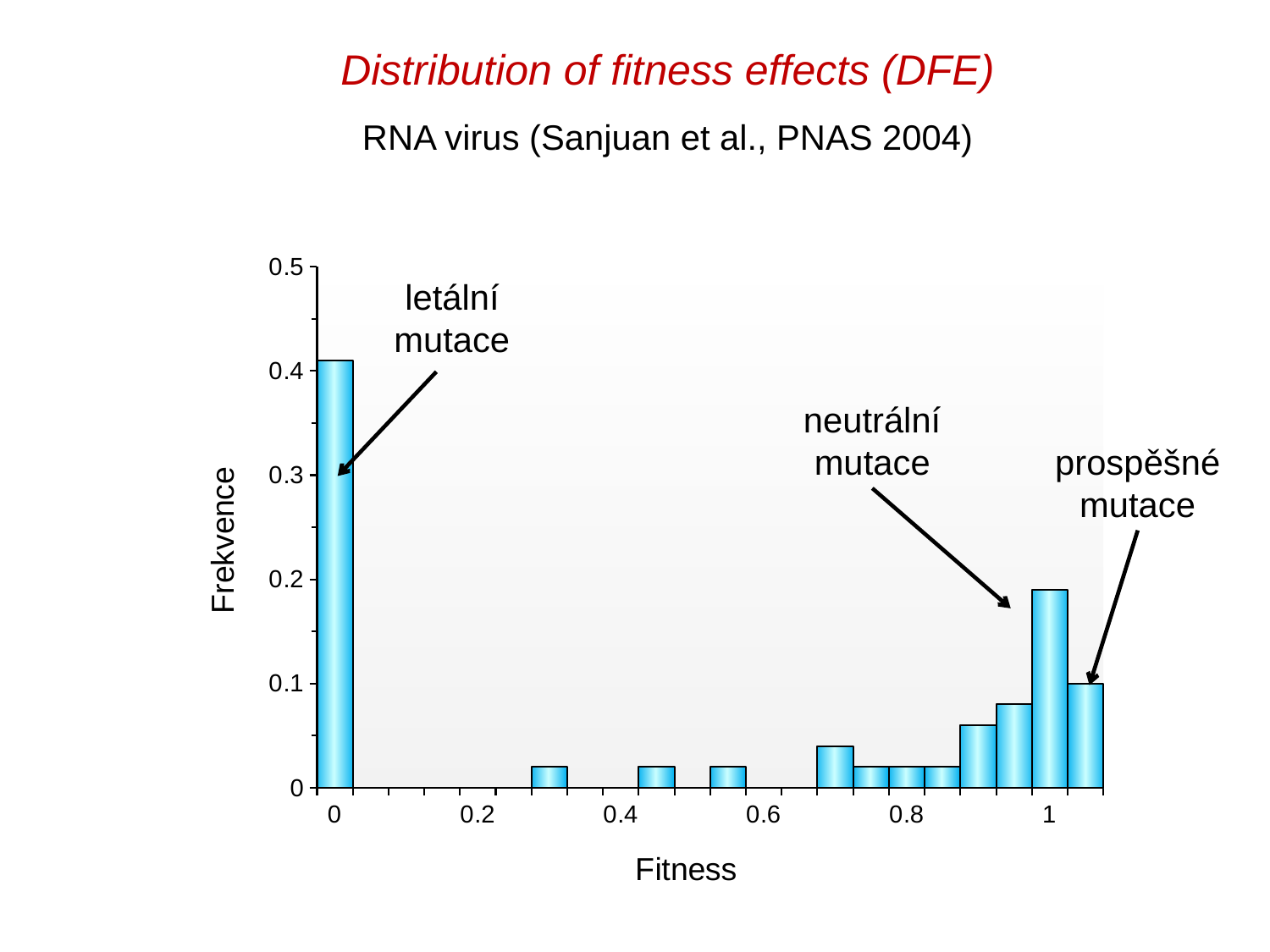
At which fitness value is the frequency highest? 0 Which has the higher frequency, the bar at fitness 0 or the bar at fitness 1? fitness 0 Which annotation points to the bar at fitness 0? letální mutace Is the frequency for fitness 0 greater or less than 0.3? greater What kind of chart is shown on the slide? bar chart Is the frequency for the bar at fitness 1 greater or less than 0.2? less Do the bar heights rise or fall as fitness increases from 0.7 to 1? rise How many bars are plotted in the chart? 12 Is the frequency for the bar at fitness 0.9 greater or less than 0.1? less What is the label of the x axis? Fitness